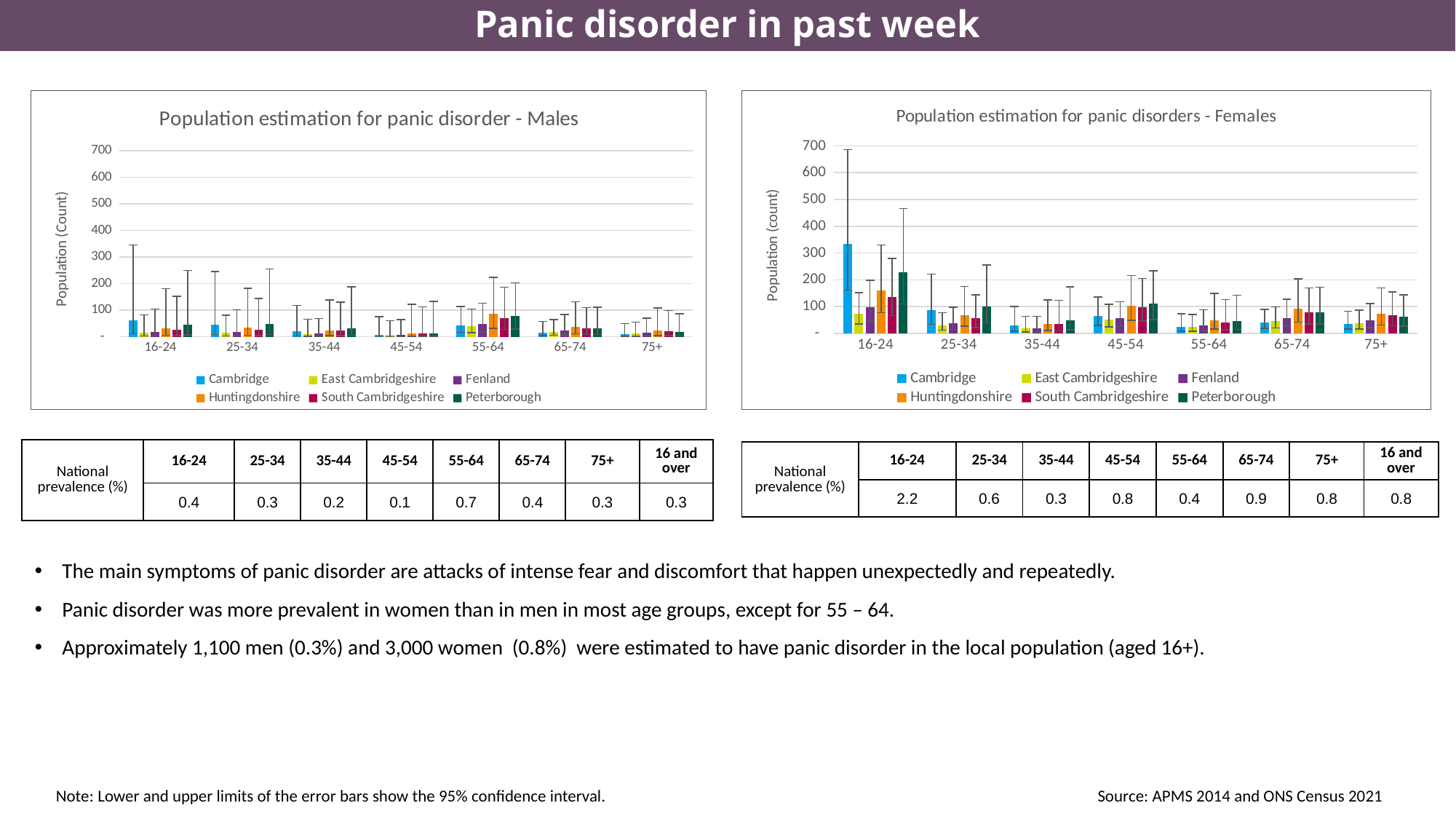
In the 'Population estimation for panic disorders - Females' chart, is the value for Cambridge in the 16-24 age group greater or less than 300? greater What is the y-axis label of the 'Population estimation for panic disorders - Females' chart? Population (count) In the 'Population estimation for panic disorders - Females' chart, is the value for Peterborough in the 16-24 age group greater or less than 200? greater How many series does the legend of the 'Population estimation for panic disorder - Males' chart list? 6 In the 'Population estimation for panic disorders - Females' chart, which is larger in the 16-24 age group: Cambridge or East Cambridgeshire? Cambridge In the 'Population estimation for panic disorder - Males' chart, is the value for Huntingdonshire in the 55-64 age group greater or less than 200? less In the 'Population estimation for panic disorders - Females' chart, which is larger in the 16-24 age group: Peterborough or Fenland? Peterborough What is the highest value shown on the y axis of the 'Population estimation for panic disorder - Males' chart? 700 How many age groups are shown on the x axis of the 'Population estimation for panic disorders - Females' chart? 7 What kind of chart is the 'Population estimation for panic disorder - Males' chart? Bar chart In the 'Population estimation for panic disorders - Females' chart, which district has the tallest bar in the 16-24 age group? Cambridge